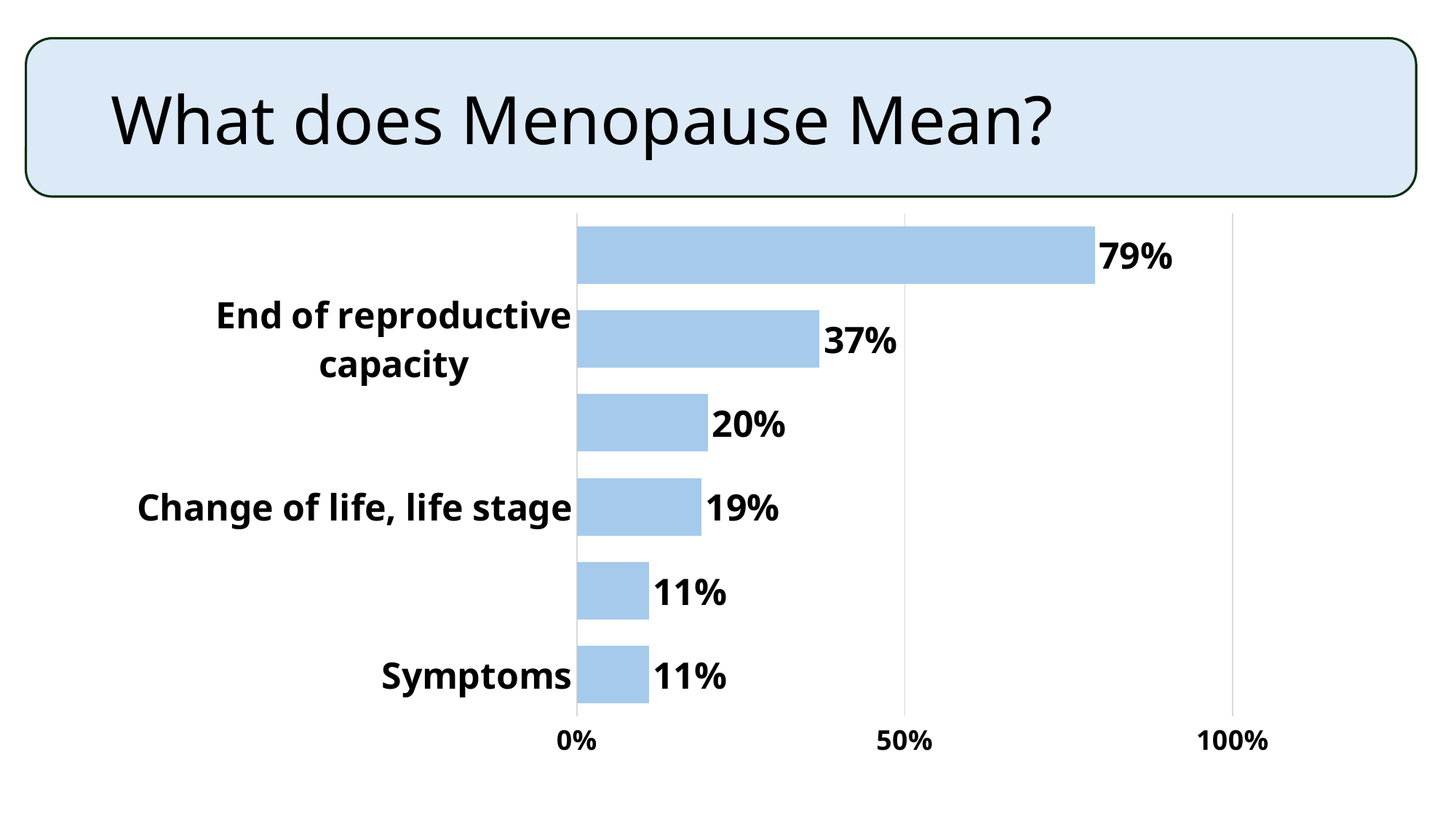
Is the value for End of reproductive capacity greater or less than 50%? less What is the title of the slide? What does Menopause Mean? What is the difference between the value for End of reproductive capacity and the value for Change of life, life stage? 18% What is the value for Symptoms? 11% What is the difference between the value for Change of life, life stage and the value for Symptoms? 8% What is the value for End of reproductive capacity? 37% What is the value for Change of life, life stage? 19% Which is larger, the value for End of reproductive capacity or the value for Symptoms? End of reproductive capacity What is the largest value shown by any bar in the chart? 79% What kind of chart is shown on the slide? Bar chart How many bars are plotted in the chart? 6 Which is larger, the value for Change of life, life stage or the value for Symptoms? Change of life, life stage